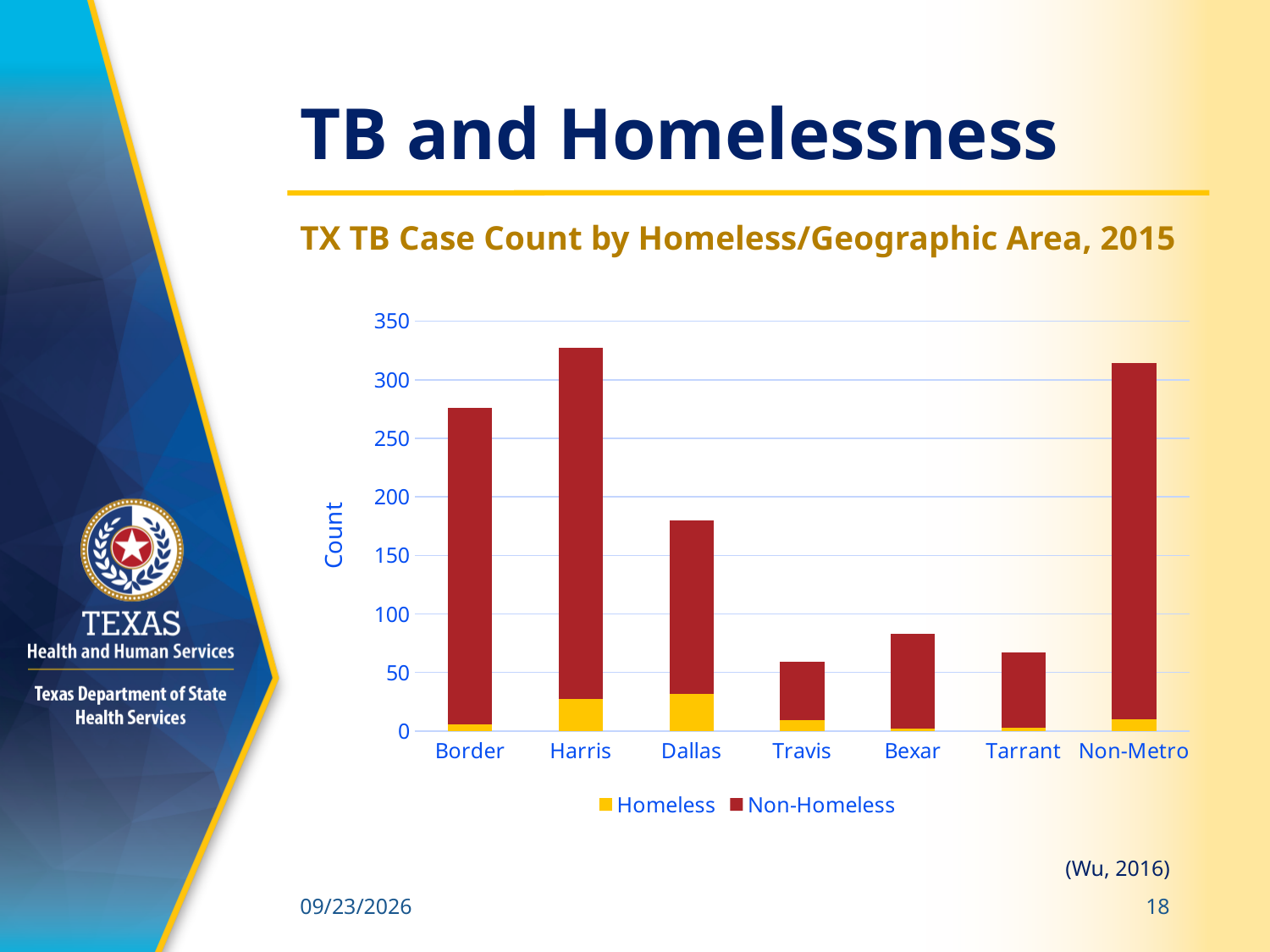
Which has a larger total TB case count, Dallas or Bexar? Dallas What kind of chart is shown on the slide? Stacked bar chart What is the title of the chart? TX TB Case Count by Homeless/Geographic Area, 2015 Is the total value for Non-Metro greater or less than 300? greater Which has a larger total TB case count, Border or Dallas? Border Which series is shown in yellow in the chart? Homeless Which geographic area has the highest total TB case count? Harris Is the total value for Bexar greater or less than 100? less Is the total value for Border greater or less than 250? greater How many series does the chart legend list? 2 How many geographic areas are shown on the x axis of the chart? 7